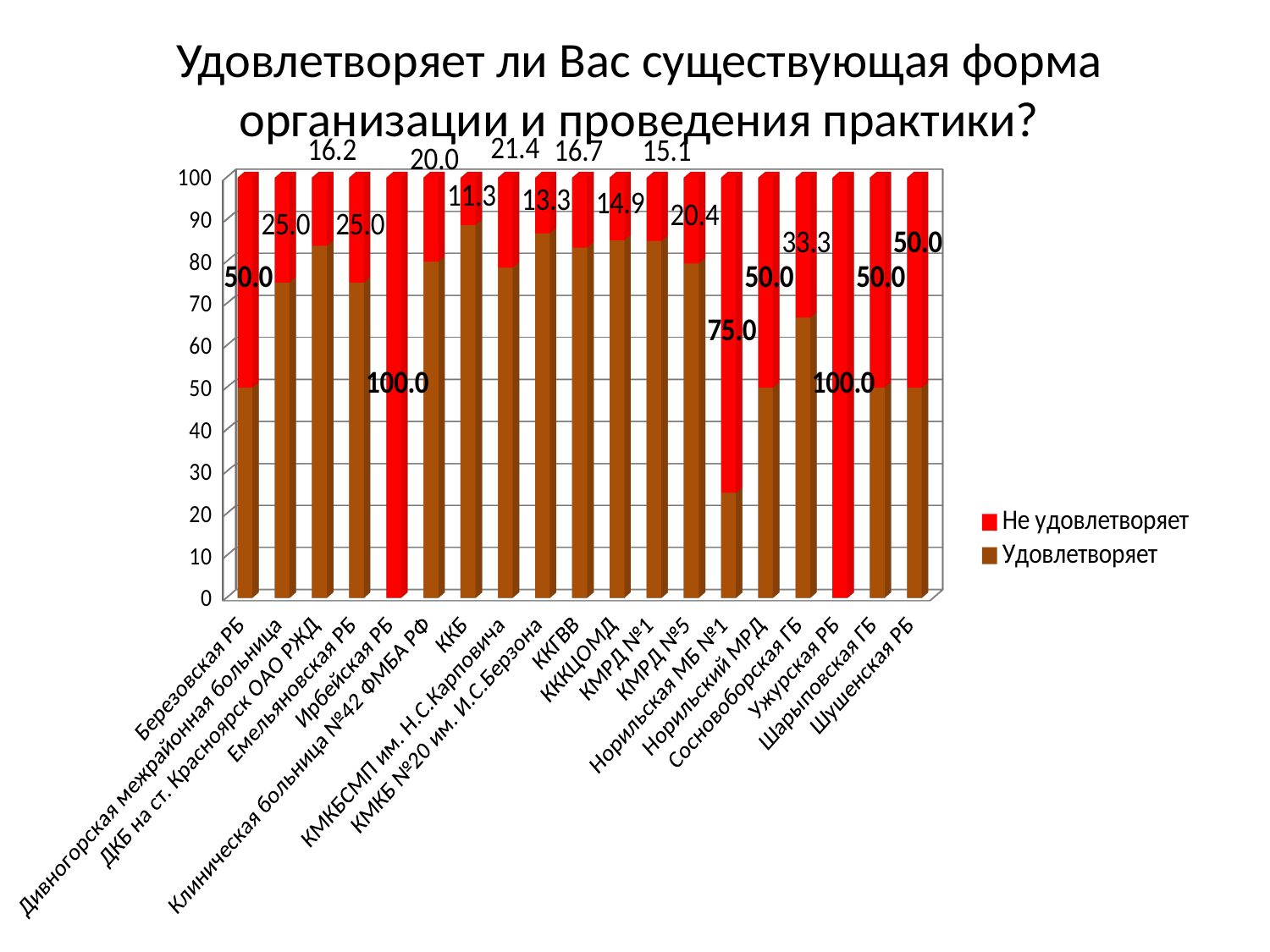
How many series does the legend list? 2 How many categories are shown on the x axis? 19 What is the value of "Не удовлетворяет" for Норильская МБ №1? 75.0 Is the "Удовлетворяет" value for Норильская МБ №1 greater or less than 30? less What is the value of "Не удовлетворяет" for ККБ? 11.3 What kind of chart is shown on the slide? stacked bar chart Which colour represents the "Удовлетворяет" series? brown What is the difference between the "Не удовлетворяет" values for Норильская МБ №1 and Сосновоборская ГБ? 41.7 Which category has the lowest value for "Не удовлетворяет"? ККБ What is the value of "Не удовлетворяет" for Сосновоборская ГБ? 33.3 Which has a larger "Не удовлетворяет" value, Норильская МБ №1 or Шушенская РБ? Норильская МБ №1 What is the value of "Не удовлетворяет" for КМКБСМП им. Н.С.Карповича? 21.4